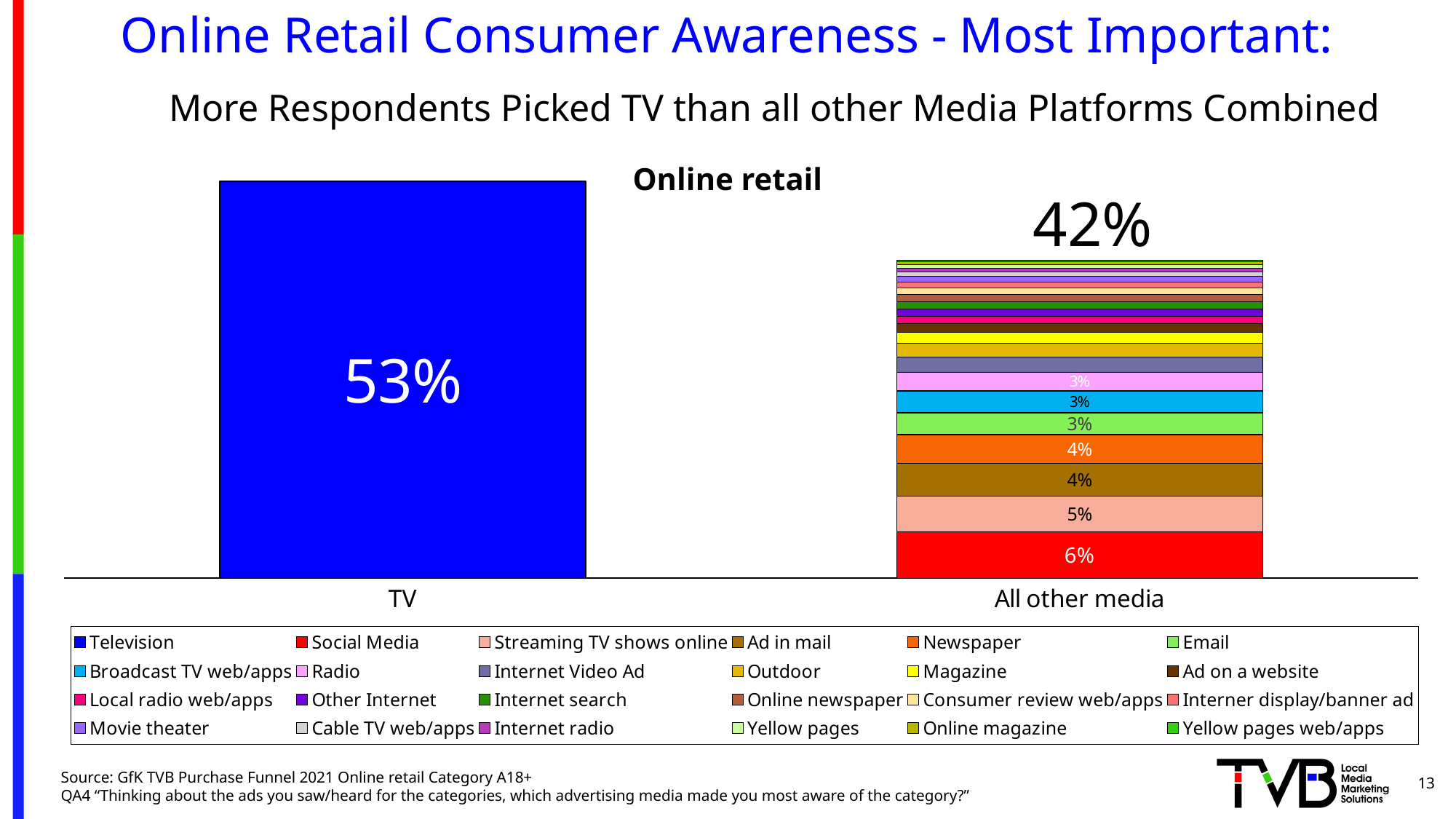
What kind of chart is shown on the slide? Bar chart How many series does the legend list? 24 What is the value for Social Media in the All other media bar? 6% What is the title of the chart? Online retail What is the total shown for the All other media stacked bar? 42% What is the value for Email in the All other media bar? 3% What is the difference between the TV value and the All other media total? 11 percentage points What is the value for Newspaper in the All other media bar? 4% How many categories are shown on the x axis? 2 What is the value shown for TV? 53% Which is larger, the TV bar or the All other media bar? TV What is the value for Streaming TV shows online in the All other media bar? 5%